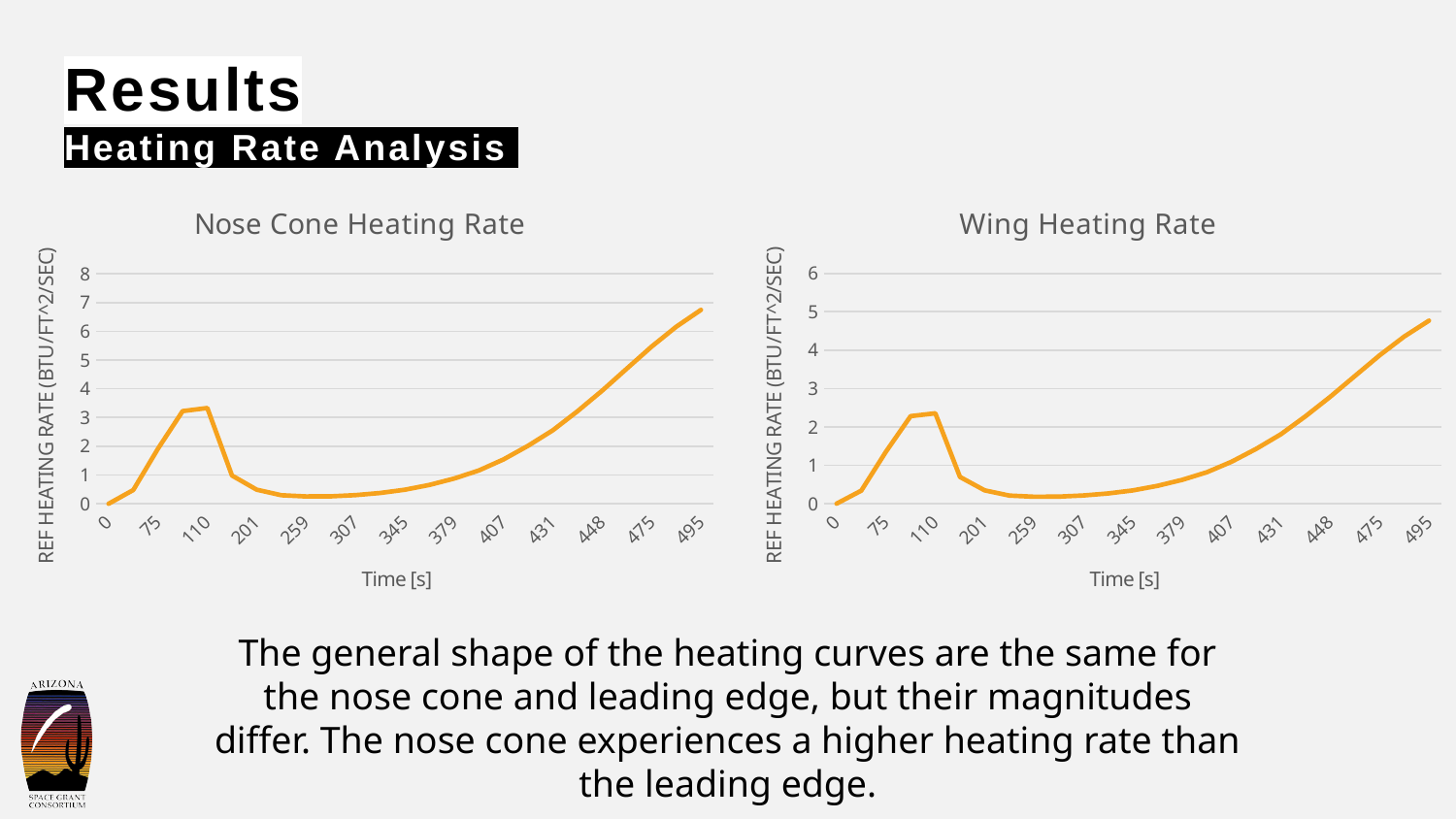
In the Nose Cone Heating Rate chart, at which time label does the heating rate reach its highest value? 495 How many time labels are shown on the x axis of the Wing Heating Rate chart? 13 In the Wing Heating Rate chart, is the value at time 495 greater or less than 4? greater In the Nose Cone Heating Rate chart, what is the heating rate at time 0? 0 What kind of chart is the Nose Cone Heating Rate chart? line chart In the Wing Heating Rate chart, at which time label is the heating rate lowest? 0 What is the y-axis label of the Wing Heating Rate chart? REF HEATING RATE (BTU/FT^2/SEC) In the Wing Heating Rate chart, is the value at time 110 greater or less than 2? greater In the Wing Heating Rate chart, what is the heating rate at time 0? 0 In the Nose Cone Heating Rate chart, does the heating rate rise or fall between time 307 and time 495? rise In the Nose Cone Heating Rate chart, is the value at time 259 greater or less than 1? less